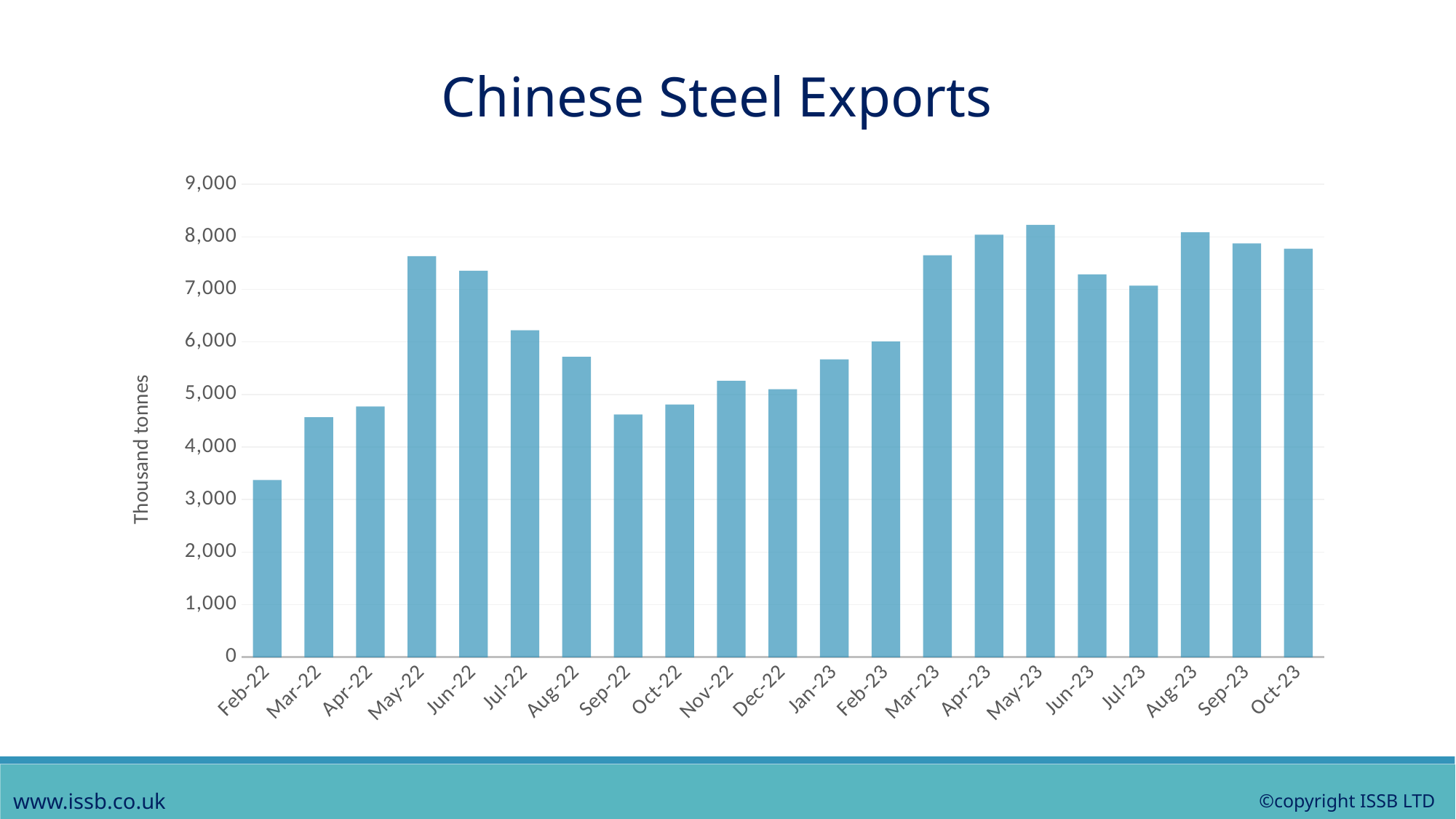
Which month has the lowest steel exports? Feb-22 Which month has the highest steel exports? May-23 What kind of chart is shown on the slide? bar chart Is the value for Sep-22 greater or less than 5,000? less What is the title of the chart? Chinese Steel Exports Is the value for Feb-22 greater or less than 4,000? less Which month has higher exports, May-22 or Jun-22? May-22 What unit is shown on the vertical axis label? Thousand tonnes Is the value for May-22 greater or less than 7,000? greater Do the values rise or fall from May-22 to Sep-22? fall How many months (bars) are plotted in the chart? 21